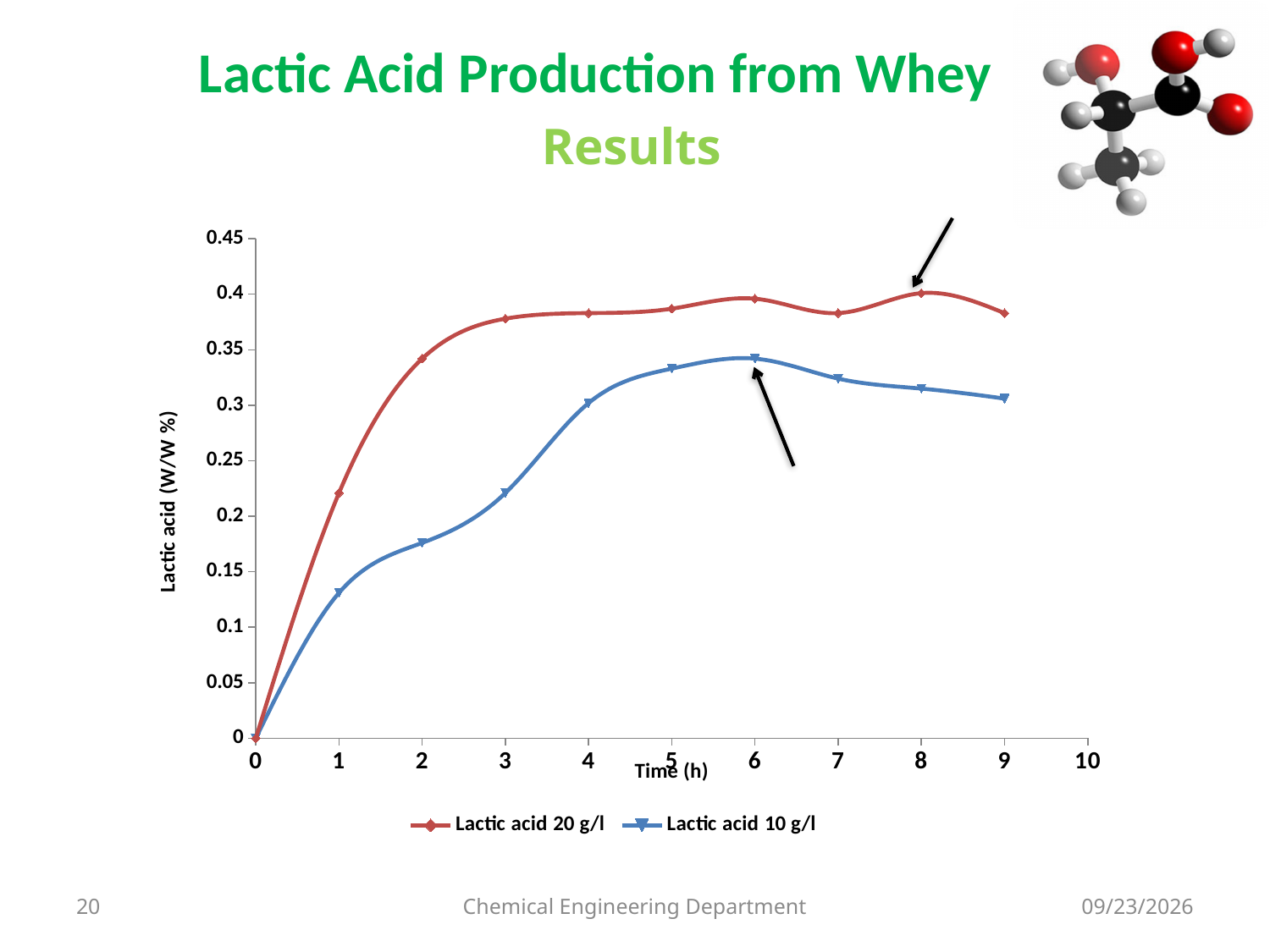
Is the value for Lactic acid 20 g/l at 2 h greater or less than 0.3? greater How many data points are plotted for the Lactic acid 20 g/l series? 10 What is the title of the y axis? Lactic acid (W/W %) Is the value for Lactic acid 10 g/l at 5 h greater or less than 0.3? greater What kind of chart is shown on the slide? line chart Is the value for Lactic acid 20 g/l at 3 h greater or less than 0.35? greater At what time does the Lactic acid 10 g/l series reach its lowest value? 0 h At 6 h, which series has the higher value, Lactic acid 20 g/l or Lactic acid 10 g/l? Lactic acid 20 g/l How many series does the legend list? 2 What is the value of Lactic acid 10 g/l at time 0 h? 0 Does the Lactic acid 20 g/l series rise or fall between 0 h and 3 h? rise